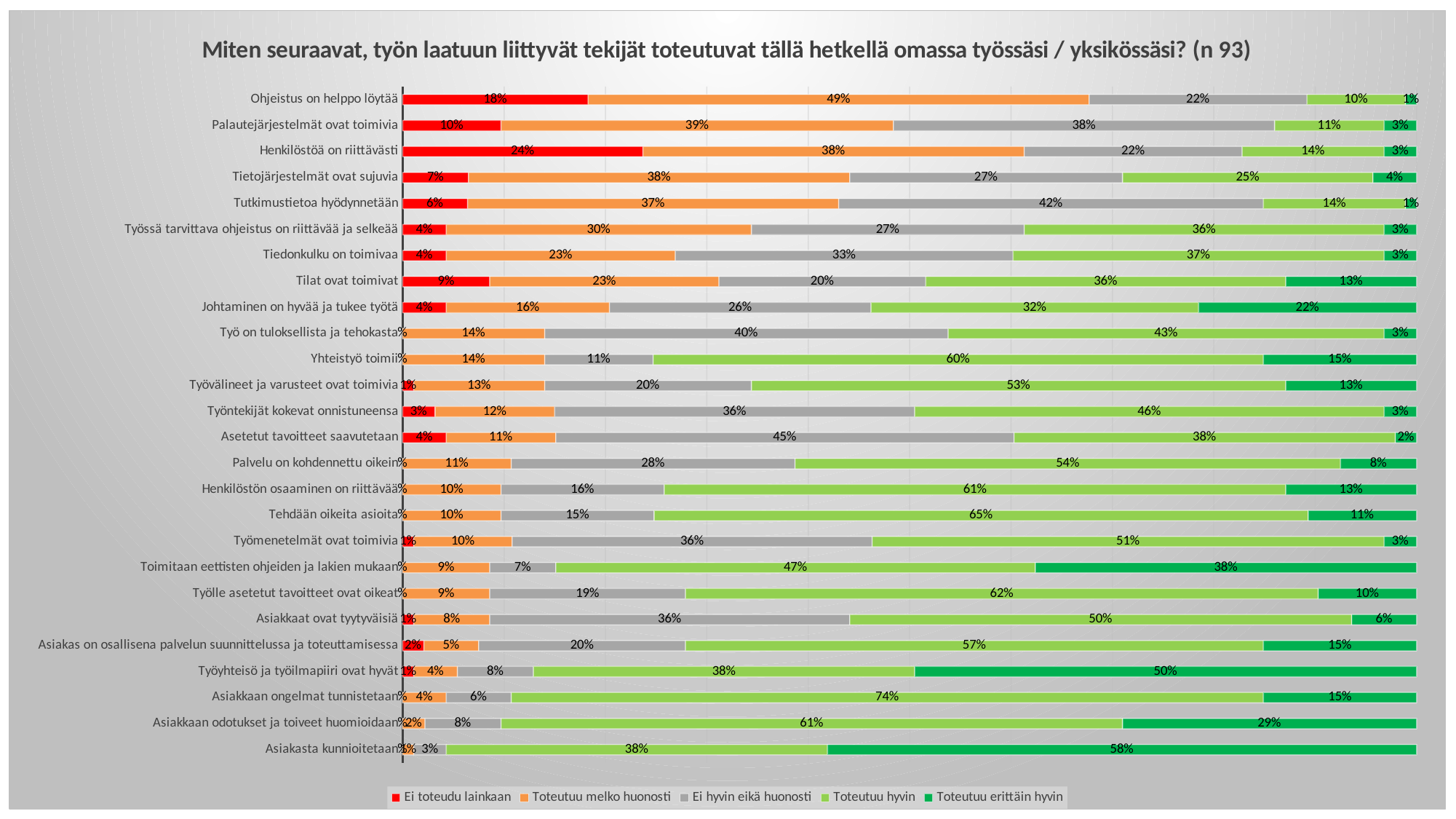
Which category has the highest 'Ei toteudu lainkaan' value? Henkilöstöä on riittävästi What is the 'Toteutuu hyvin' value for 'Asiakkaan ongelmat tunnistetaan'? 74% How many categories (statements) are plotted in the chart? 26 Which category has the highest 'Toteutuu erittäin hyvin' value? Asiakasta kunnioitetaan What is the difference between the 'Toteutuu melko huonosti' value (49%) and the 'Ei toteudu lainkaan' value (18%) for 'Ohjeistus on helppo löytää'? 31 percentage points How many series does the legend list? 5 What kind of chart is shown on the slide? Stacked bar chart What is the 'Ei hyvin eikä huonosti' value for 'Asetetut tavoitteet saavutetaan'? 45% What is the 'Toteutuu erittäin hyvin' value for 'Asiakasta kunnioitetaan'? 58% What is the sample size (n) stated in the chart title? 93 What is the 'Toteutuu melko huonosti' value for 'Ohjeistus on helppo löytää'? 49% Which is larger: the 'Toteutuu hyvin' value for 'Tehdään oikeita asioita' or for 'Työlle asetetut tavoitteet ovat oikeat'? Tehdään oikeita asioita